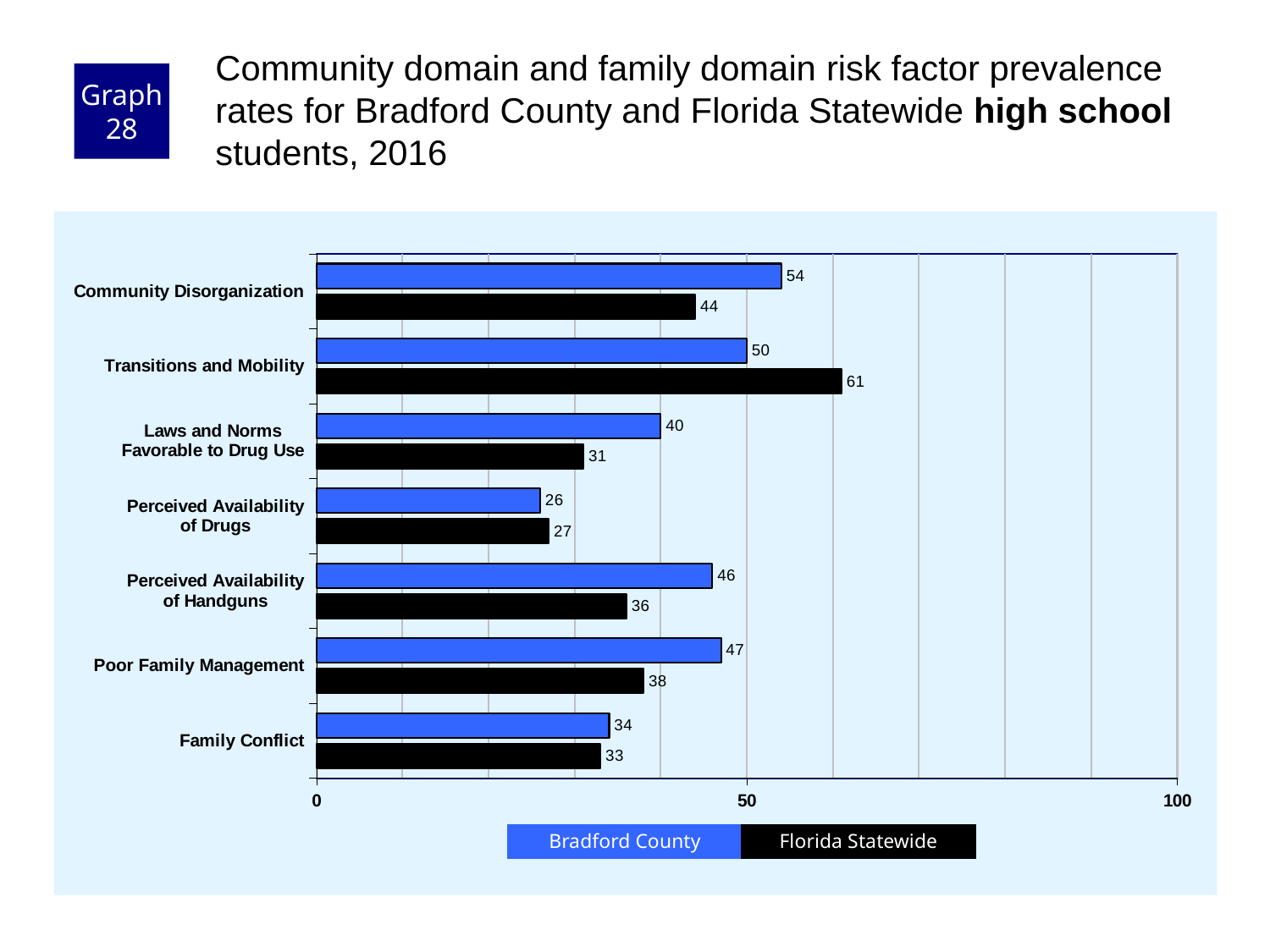
Which risk factor has the highest Bradford County value? Community Disorganization Which risk factor has the lowest Bradford County value? Perceived Availability of Drugs How many series does the legend list? 2 Which risk factor has the highest Florida Statewide value? Transitions and Mobility For Poor Family Management, which is larger: the Bradford County value or the Florida Statewide value? Bradford County How many risk factors are shown on the chart? 7 What is the Bradford County value for Community Disorganization? 54 What is the Florida Statewide value for Transitions and Mobility? 61 What is the difference between the Bradford County and Florida Statewide values for Laws and Norms Favorable to Drug Use? 9 What kind of chart is shown on the slide? Bar chart Which colour represents Florida Statewide in the chart? Black What is the Florida Statewide value for Perceived Availability of Handguns? 36